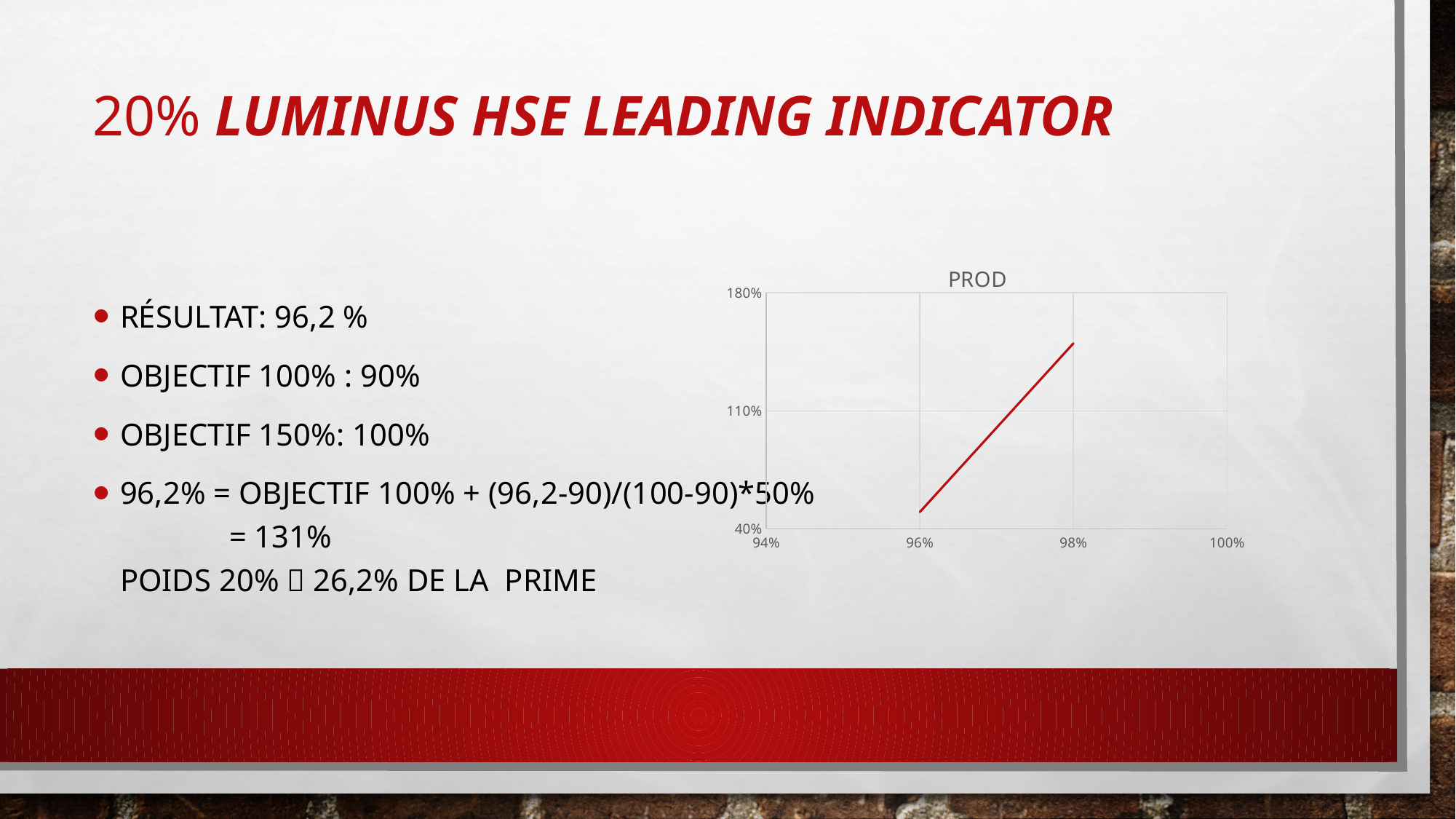
What kind of chart is shown on the slide? line chart Does the line in the PROD chart rise or fall as the x-axis value increases from 96% to 98%? rise In the PROD chart, is the value at 96% greater or less than 110%? less In the PROD chart, which x-axis value has the higher plotted value, 96% or 98%? 98% What is the title of the chart? PROD In the PROD chart, is the value at 98% greater or less than 110%? greater In the PROD chart, is the value at 98% greater or less than 180%? less What is the highest value shown on the y-axis of the PROD chart? 180% What is the lowest value shown on the x-axis of the PROD chart? 94%